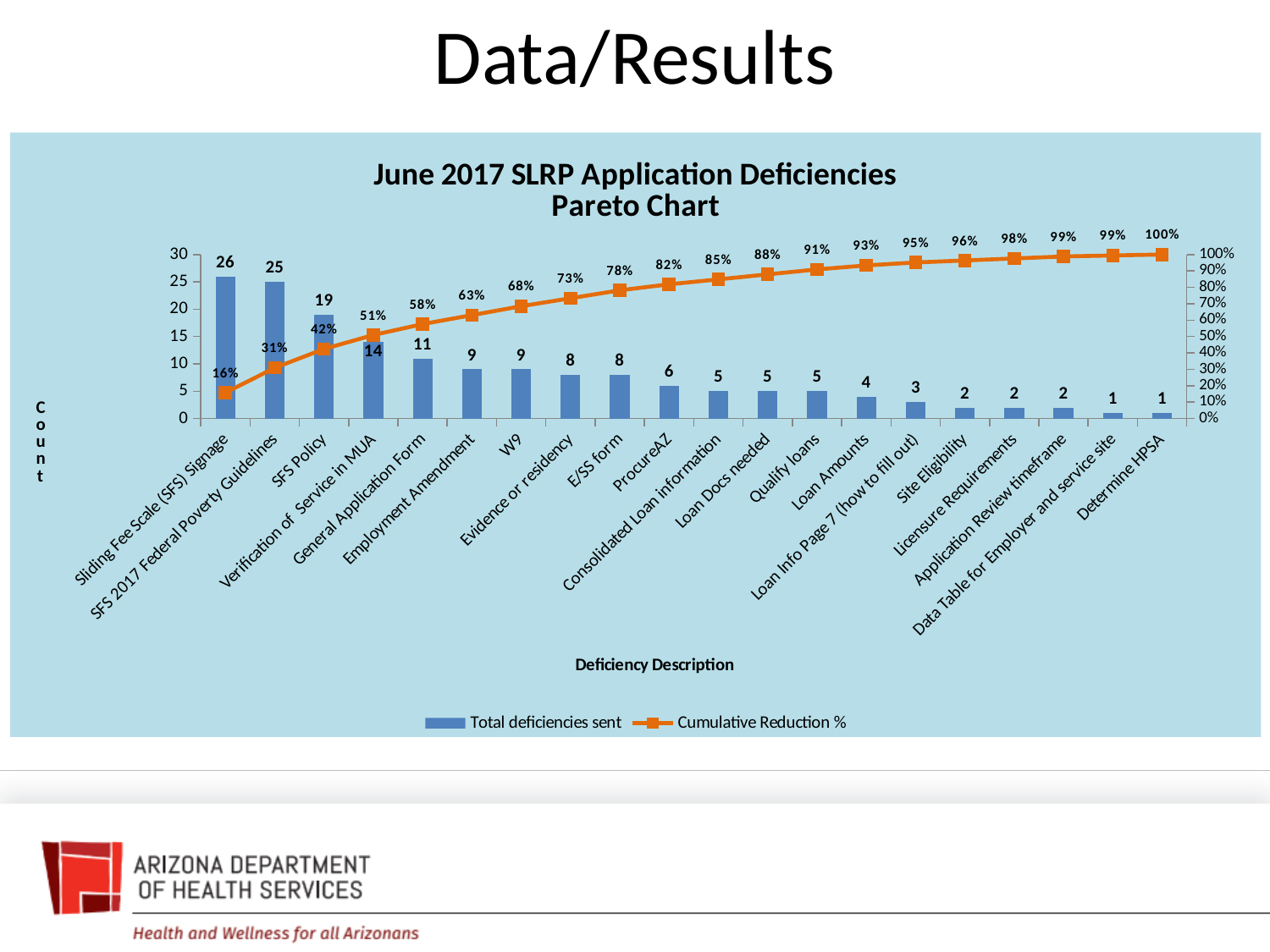
How many deficiency descriptions are shown on the x axis? 20 Which deficiency description has the highest count of total deficiencies sent? Sliding Fee Scale (SFS) Signage What is the difference in total deficiencies sent between Sliding Fee Scale (SFS) Signage and SFS 2017 Federal Poverty Guidelines? 1 What is the cumulative reduction percentage at General Application Form? 58% How many total deficiencies were sent for ProcureAZ? 6 What kind of chart is shown on the slide? Pareto chart (bar chart with a cumulative percentage line) What is the cumulative reduction percentage at Determine HPSA? 100% What is the title of the chart? June 2017 SLRP Application Deficiencies Pareto Chart How many total deficiencies were sent for SFS Policy? 19 How many series does the legend list? 2 Which has more total deficiencies sent, Verification of Service in MUA or Loan Amounts? Verification of Service in MUA Do the total deficiencies sent rise or fall from left to right along the x axis? Fall